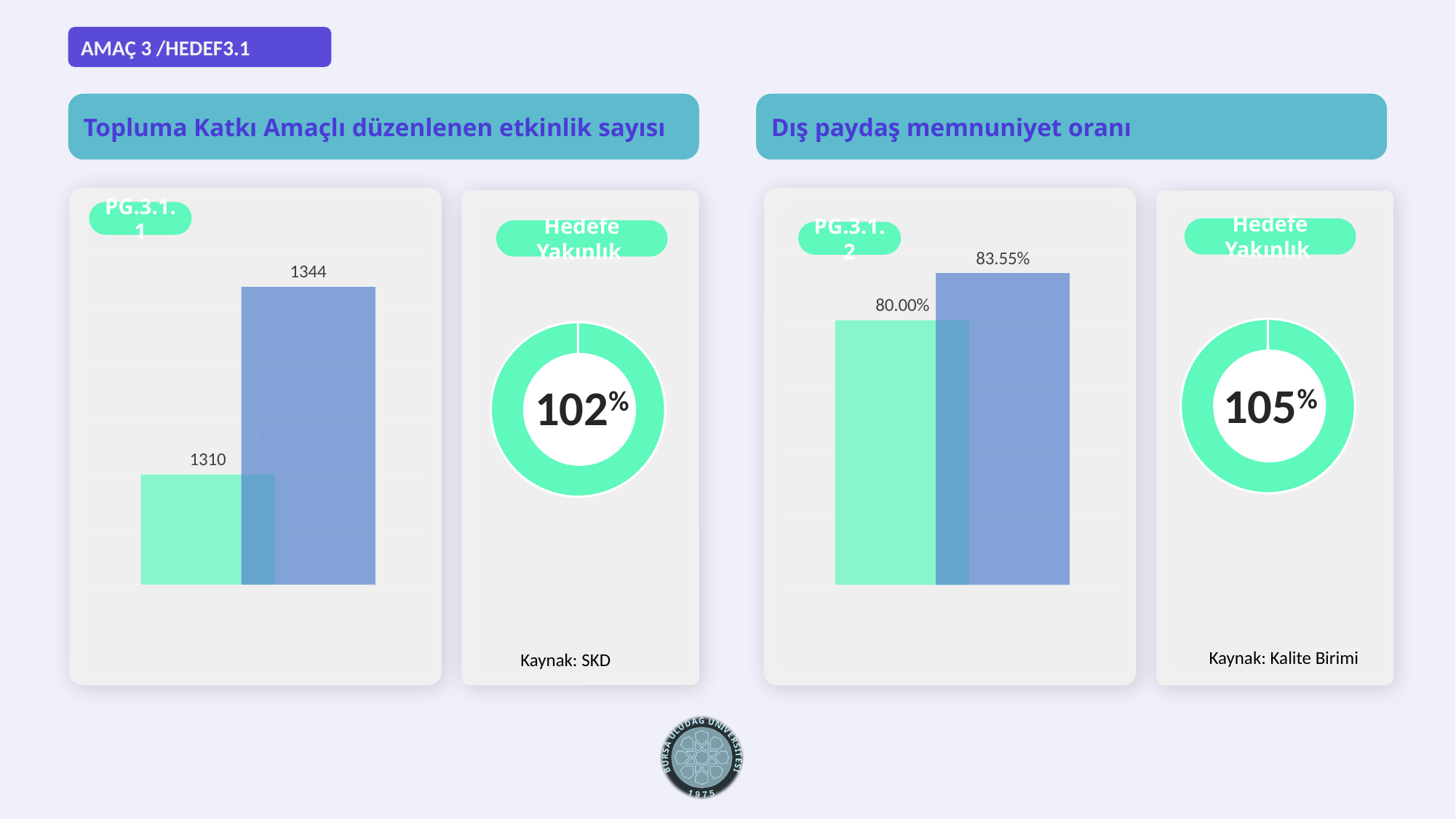
What percentage is shown in the 'Hedefe Yakınlık' donut chart next to the 'Dış paydaş memnuniyet oranı' chart? 105% In the 'Dış paydaş memnuniyet oranı' chart, what value is labelled on the blue bar? 83.55% In the 'Dış paydaş memnuniyet oranı' chart, what value is labelled on the green bar? 80.00% In the 'Dış paydaş memnuniyet oranı' chart, what is the difference between the blue bar and the green bar? 3.55% In the 'Dış paydaş memnuniyet oranı' chart, which bar has the higher value, the green one or the blue one? the blue one How many bars are plotted in the 'Topluma Katkı Amaçlı düzenlenen etkinlik sayısı' chart? 2 What kind of chart is used under 'Dış paydaş memnuniyet oranı' to show the 80.00% and 83.55% values? bar chart In the 'Topluma Katkı Amaçlı düzenlenen etkinlik sayısı' chart, what is the difference between the blue bar and the green bar? 34 In the 'Topluma Katkı Amaçlı düzenlenen etkinlik sayısı' chart, what value is labelled on the blue bar? 1344 In the 'Topluma Katkı Amaçlı düzenlenen etkinlik sayısı' chart, what value is labelled on the green bar? 1310 In the 'Topluma Katkı Amaçlı düzenlenen etkinlik sayısı' chart, which bar is taller, the green one or the blue one? the blue one What percentage is shown in the 'Hedefe Yakınlık' donut chart next to the 'Topluma Katkı Amaçlı düzenlenen etkinlik sayısı' chart? 102%